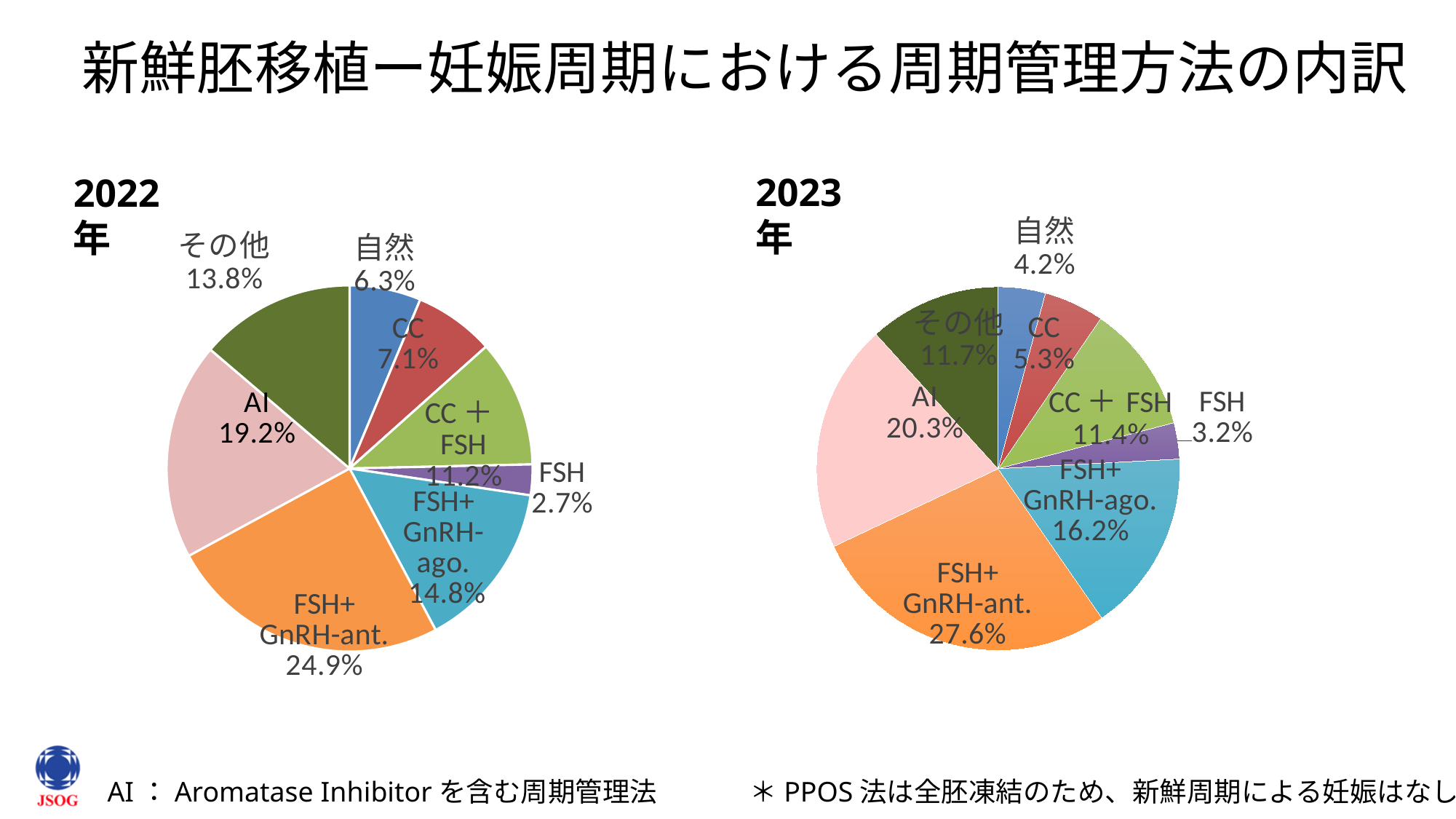
In the 2022年 pie chart, which category has the smallest share? FSH What type of chart is used for the 2022年 data? Pie chart How many slices does the 2023年 pie chart have? 8 In the 2022年 pie chart, which category has the largest share? FSH+GnRH-ant. In the 2023年 pie chart, which is larger: the share of CC＋FSH or the share of その他? その他 In the 2023年 pie chart, which category has the smallest share? FSH In the 2022年 pie chart, what share does FSH+GnRH-ant. have? 24.9% In the 2023年 pie chart, what is the difference between the shares of FSH+GnRH-ant. and FSH+GnRH-ago.? 11.4% In the 2022年 pie chart, what is the difference between the shares of AI and その他? 5.4% In the 2023年 pie chart, what share does AI have? 20.3% In the 2022年 pie chart, what share does CC have? 7.1% Which is larger: the share of 自然 in the 2022年 pie chart or in the 2023年 pie chart? 2022年